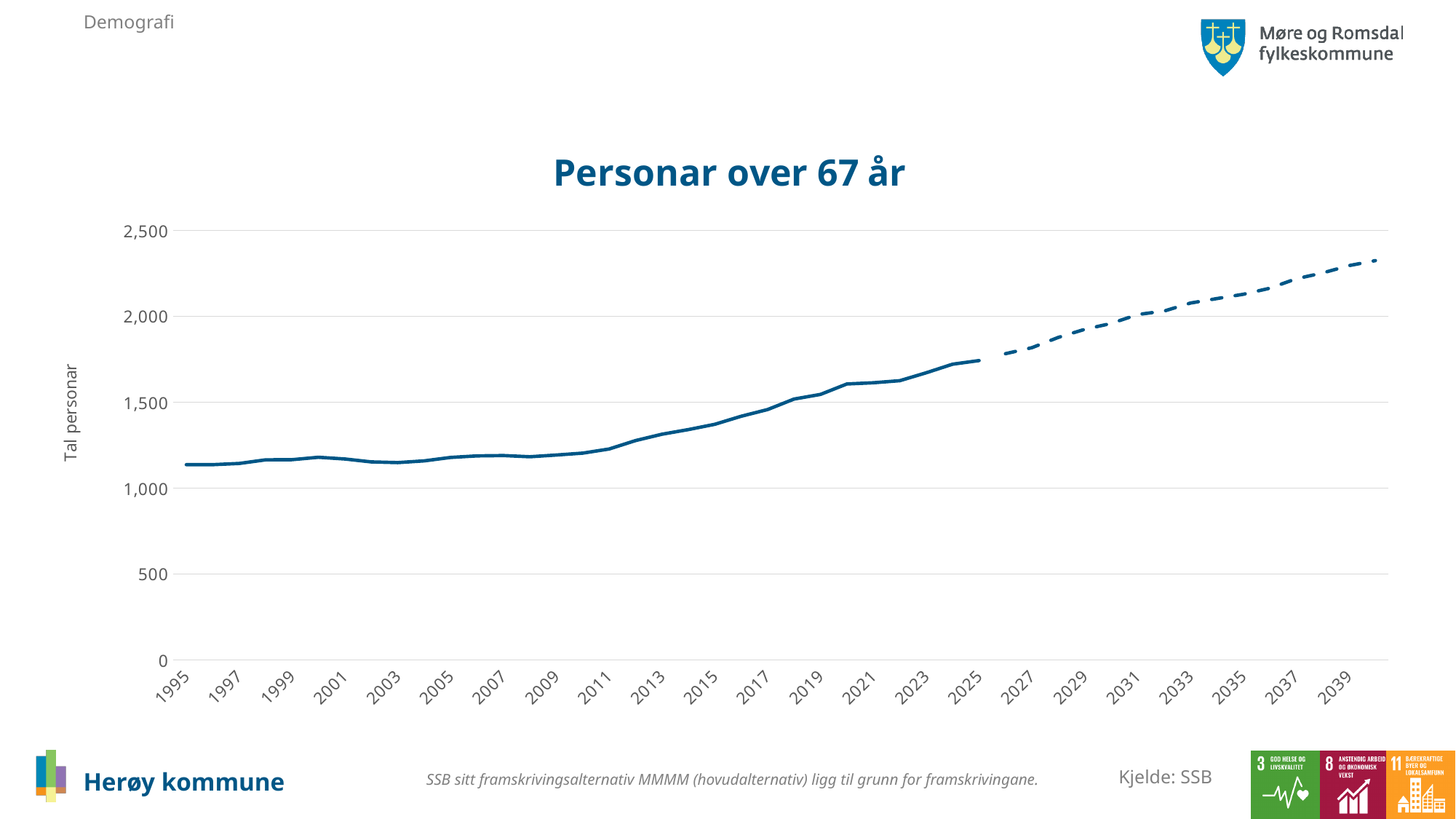
Is the value for 1995 greater or less than 1,500? less Which is larger, the value for 2019 or the value for 2009? 2019 Do the values in the chart generally rise or fall from 1995 to 2039? rise Is the value for 2005 greater or less than 1,500? less What is the title of the chart? Personar over 67 år What is the label on the vertical axis of the chart? Tal personar How many year labels are shown on the x axis? 23 Is the value for 2039 greater or less than 2,000? greater What kind of chart is shown on the slide? line chart Which year shown on the x axis has the highest value? 2039